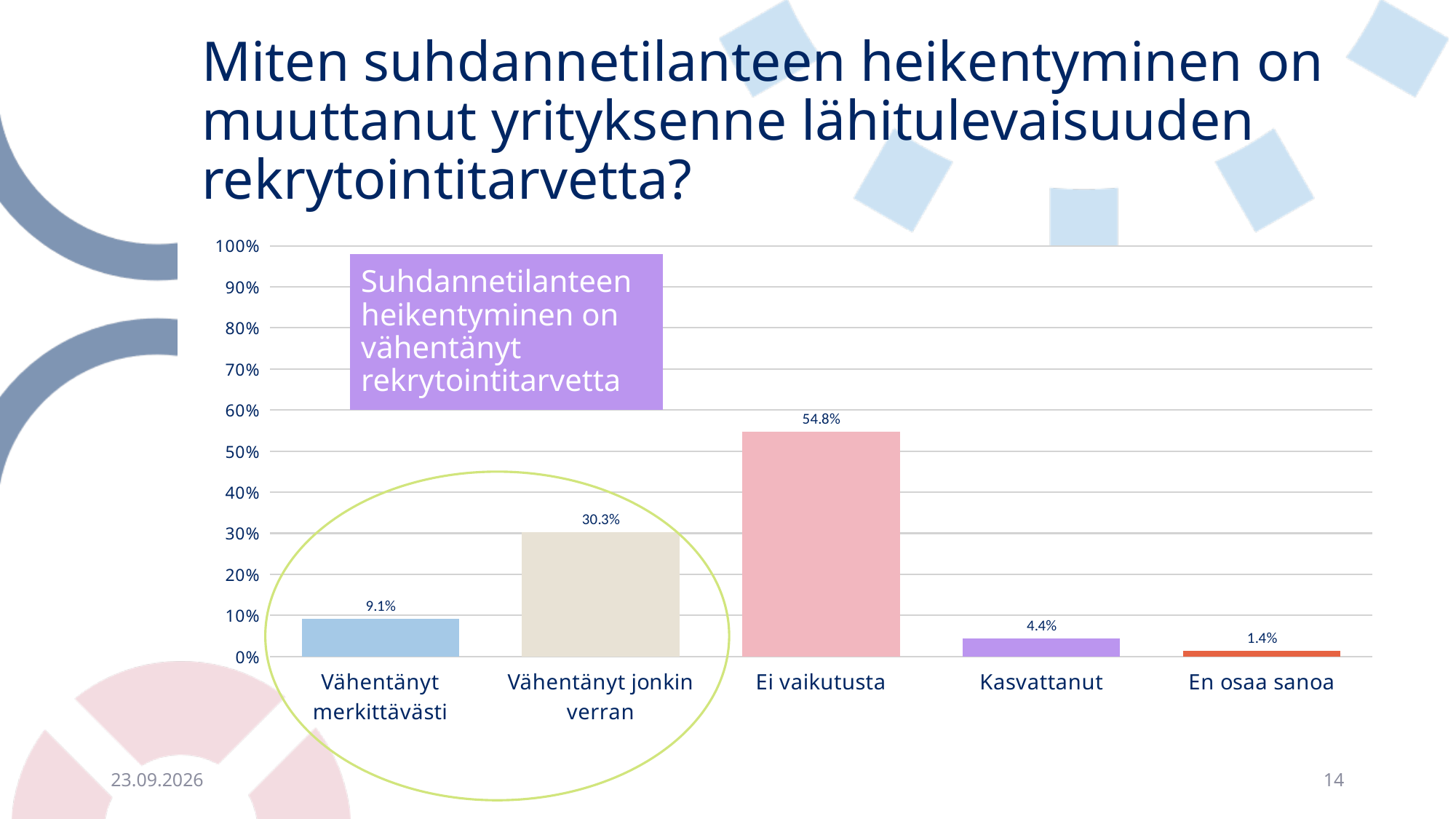
Is the value for "Ei vaikutusta" greater or less than 50%? greater What is the difference between the values for "Ei vaikutusta" and "Vähentänyt jonkin verran"? 24.5% How many categories are shown on the x axis? 5 What is the value for "Kasvattanut"? 4.4% Which category has the highest value? Ei vaikutusta What is the value for "En osaa sanoa"? 1.4% Which category has the lowest value? En osaa sanoa What is the value for "Ei vaikutusta"? 54.8% What is the value for "Vähentänyt jonkin verran"? 30.3% What kind of chart is shown on the slide? bar chart Which is larger, the value for "Vähentänyt merkittävästi" or the value for "Kasvattanut"? Vähentänyt merkittävästi What is the value for "Vähentänyt merkittävästi"? 9.1%